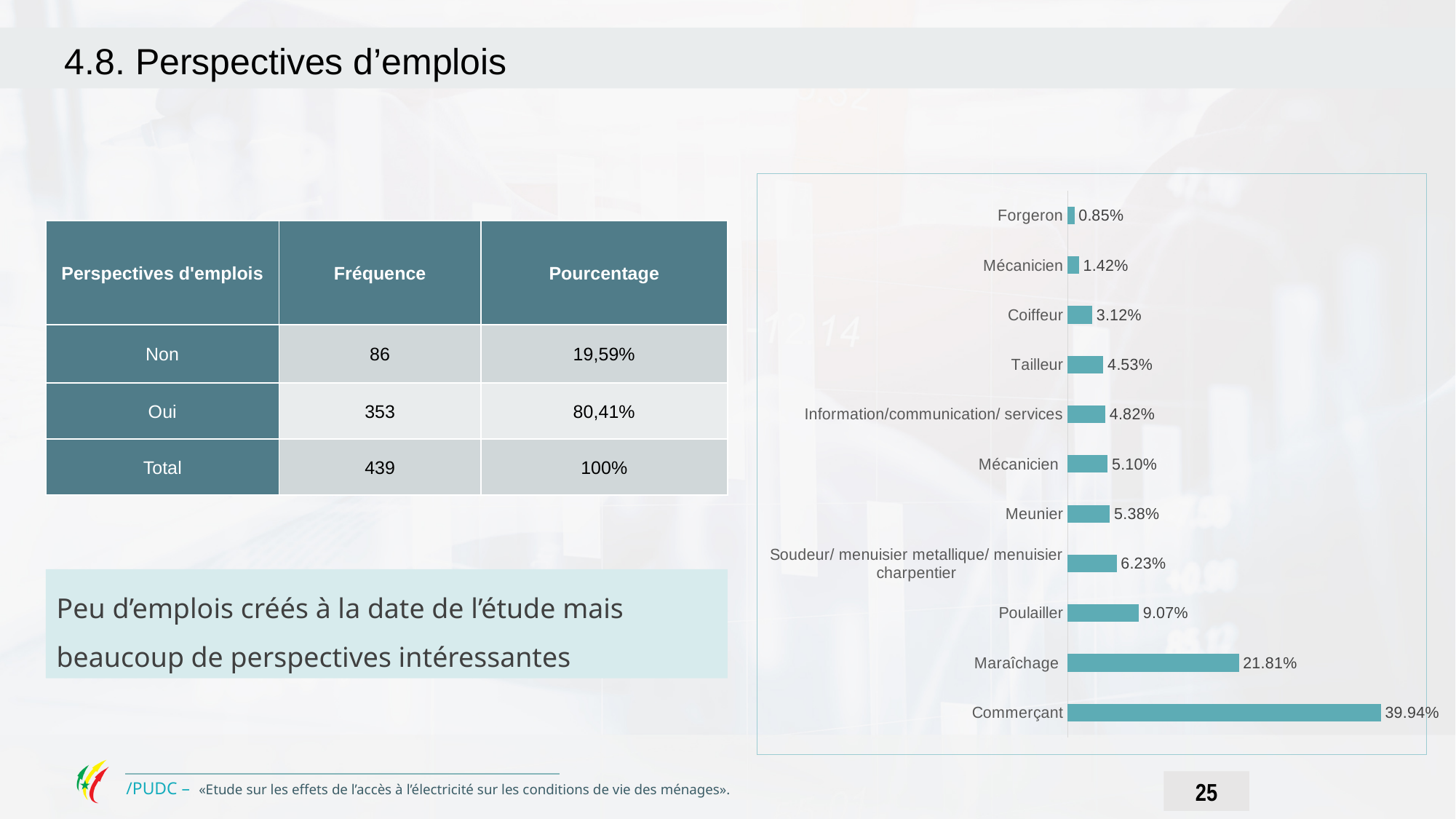
What is the value for Commerçant in the bar chart? 39.94% What is the difference between the values for Poulailler and Meunier in the bar chart? 3.69% What is the value for Soudeur/ menuisier metallique/ menuisier charpentier in the bar chart? 6.23% How many bars are shown in the bar chart? 11 Which category has the highest value in the bar chart? Commerçant What is the value for Poulailler in the bar chart? 9.07% What kind of chart is shown on the right side of the slide? Bar chart What is the value for Maraîchage in the bar chart? 21.81% What is the value for Forgeron in the bar chart? 0.85% What is the difference between the values for Commerçant and Maraîchage in the bar chart? 18.13% Which has a larger value in the bar chart, Tailleur or Coiffeur? Tailleur Which category has the lowest value in the bar chart? Forgeron